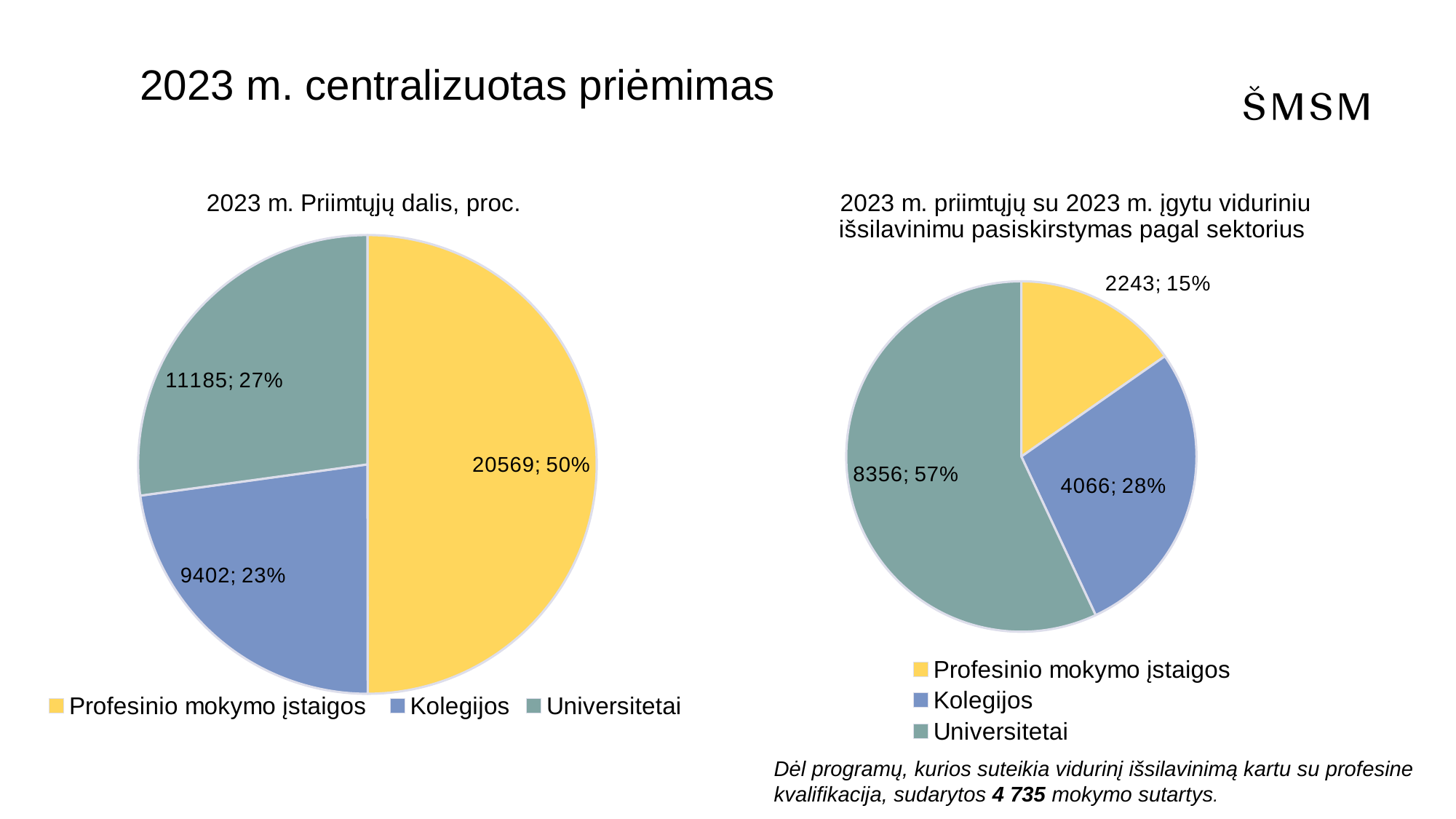
In the right chart (pasiskirstymas pagal sektorius), what value is shown for Universitetai? 8356; 57% In the left chart titled "2023 m. Priimtųjų dalis, proc.", which category has the largest slice? Profesinio mokymo įstaigos How many categories does the legend of the right chart (pasiskirstymas pagal sektorius) list? 3 In the right chart (pasiskirstymas pagal sektorius), what value is shown for Profesinio mokymo įstaigos? 2243; 15% In the left chart titled "2023 m. Priimtųjų dalis, proc.", what value is shown for Profesinio mokymo įstaigos? 20569; 50% In the left chart titled "2023 m. Priimtųjų dalis, proc.", what share of the pie does Universitetai have? 27% What type of chart is the left chart titled "2023 m. Priimtųjų dalis, proc."? Pie chart In the left chart titled "2023 m. Priimtųjų dalis, proc.", what is the difference between the Universitetai count and the Kolegijos count? 1783 In the left chart titled "2023 m. Priimtųjų dalis, proc.", what value is shown for Kolegijos? 9402; 23% In the left chart titled "2023 m. Priimtųjų dalis, proc.", which category has the smallest slice? Kolegijos In the right chart (pasiskirstymas pagal sektorius), which category has the largest slice? Universitetai In the right chart (pasiskirstymas pagal sektorius), which is larger, Kolegijos or Profesinio mokymo įstaigos? Kolegijos